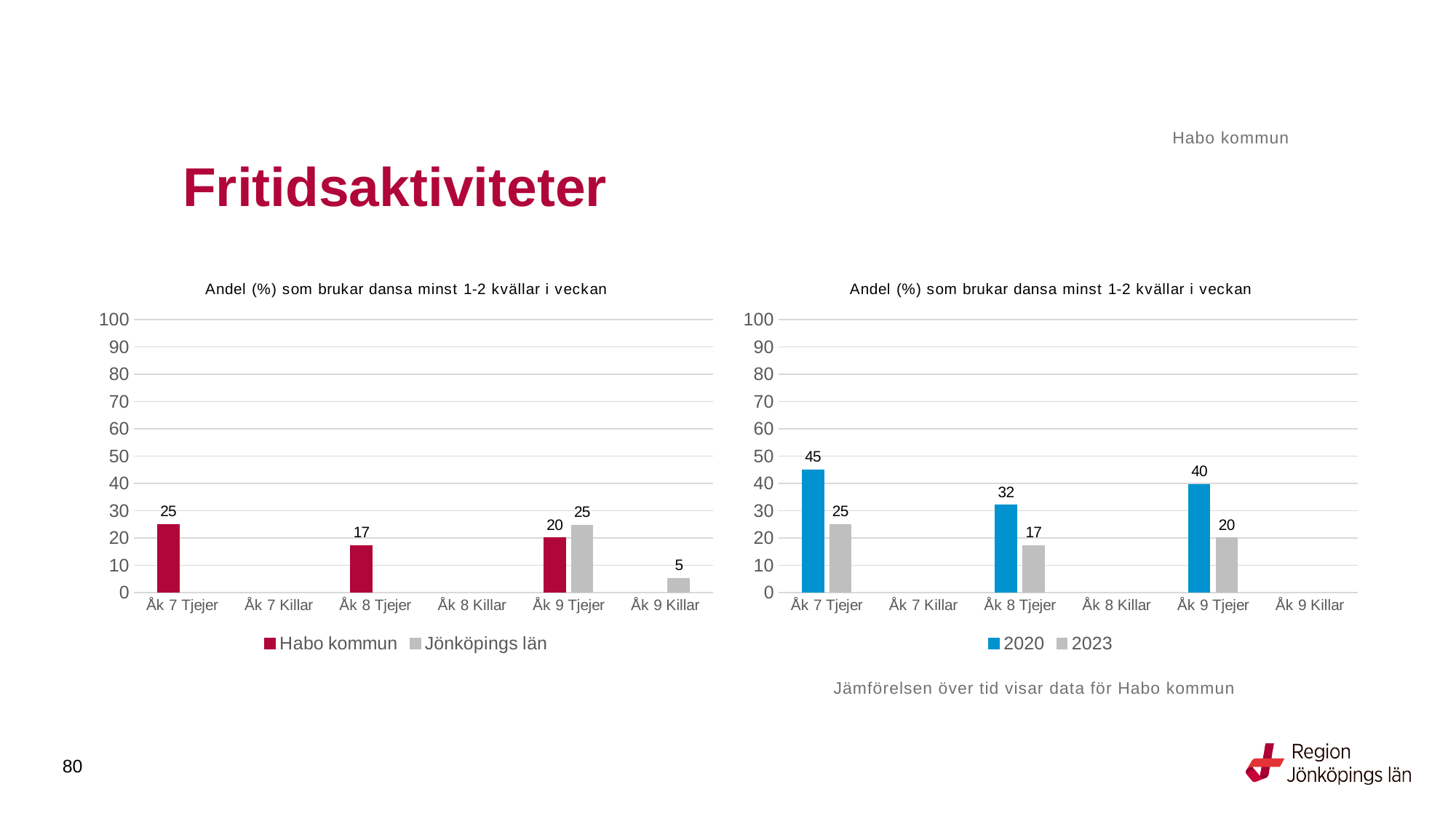
In the left chart, which series does the legend list first? Habo kommun In the right chart, which is larger for Åk 9 Tjejer: 2020 or 2023? 2020 What kind of chart is the left chart? Bar chart In the right chart, which category has the highest value for 2020? Åk 7 Tjejer In the right chart, what is the value for 2020 for Åk 7 Tjejer? 45 In the left chart, what is the difference between Jönköpings län and Habo kommun for Åk 9 Tjejer? 5 In the left chart, what is the value for Habo kommun for Åk 7 Tjejer? 25 In the right chart, what is the value for 2023 for Åk 9 Tjejer? 20 In the right chart, what is the difference between 2020 and 2023 for Åk 8 Tjejer? 15 In the left chart, what is the value for Jönköpings län for Åk 9 Killar? 5 How many series does the legend of the right chart list? 2 In the left chart, what is the value for Habo kommun for Åk 8 Tjejer? 17